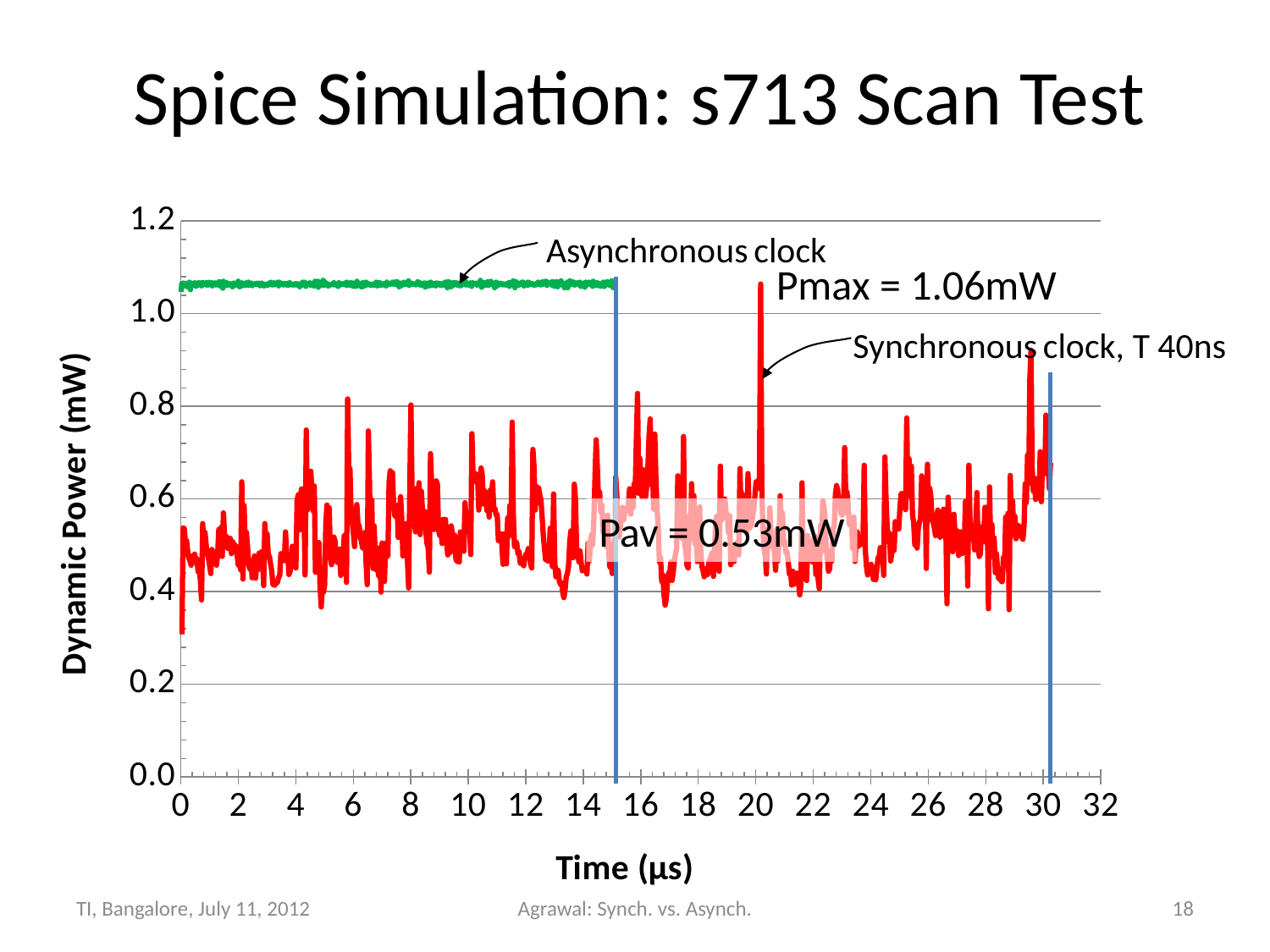
What is the Pmax value annotated on the chart? 1.06mW Is the asynchronous clock power at 10 µs greater or less than 1.0 mW? greater What is the title of the chart on the slide? Spice Simulation: s713 Scan Test Is the synchronous clock power at 2 µs greater or less than 0.8 mW? less Does the asynchronous clock line rise, fall, or stay flat over time? stay flat What is the clock period given for the synchronous clock in the annotation? T 40ns What kind of chart is shown on the slide? line chart How many clock waveforms are plotted on the chart? 2 At 8 µs, which line shows higher dynamic power, the asynchronous clock or the synchronous clock? Asynchronous clock What is the difference between the annotated Pmax and Pav values? 0.53mW What is the Pav value annotated on the chart? 0.53mW What is the label of the vertical axis? Dynamic Power (mW)